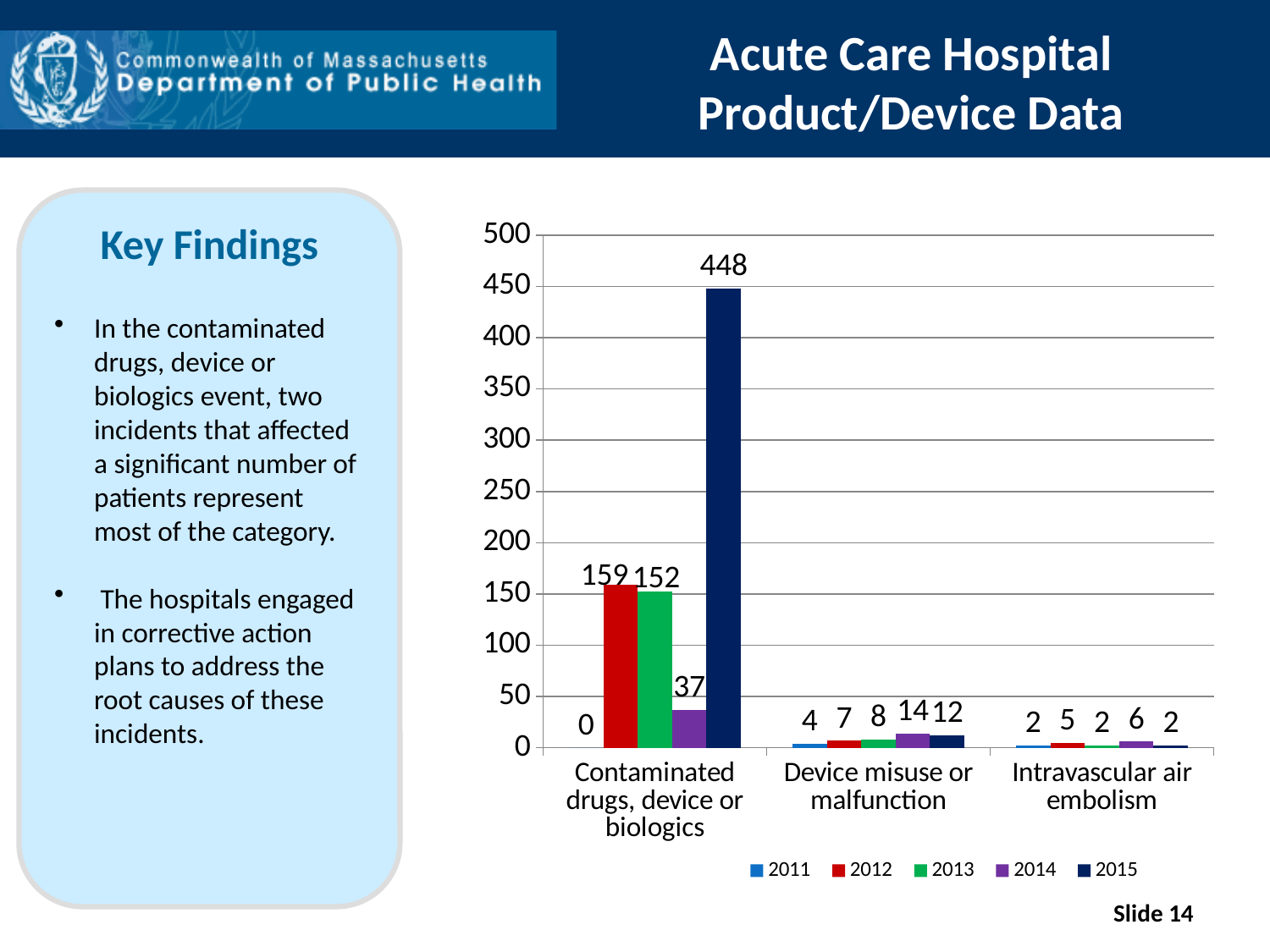
Which year has the highest value in the Contaminated drugs, device or biologics category? 2015 Which is larger in the Device misuse or malfunction category: the 2014 value or the 2015 value? 2014 What is the value for 2014 in the Intravascular air embolism category? 6 What is the difference between the 2015 and 2012 values in the Contaminated drugs, device or biologics category? 289 What is the value for 2014 in the Device misuse or malfunction category? 14 Do the values for the Device misuse or malfunction category rise or fall from 2011 to 2014? Rise What is the value for 2012 in the Contaminated drugs, device or biologics category? 159 Which year has the lowest value in the Contaminated drugs, device or biologics category? 2011 How many categories are shown on the x axis? 3 How many series does the legend list? 5 What is the value for 2015 in the Contaminated drugs, device or biologics category? 448 What kind of chart is shown on the slide? Bar chart